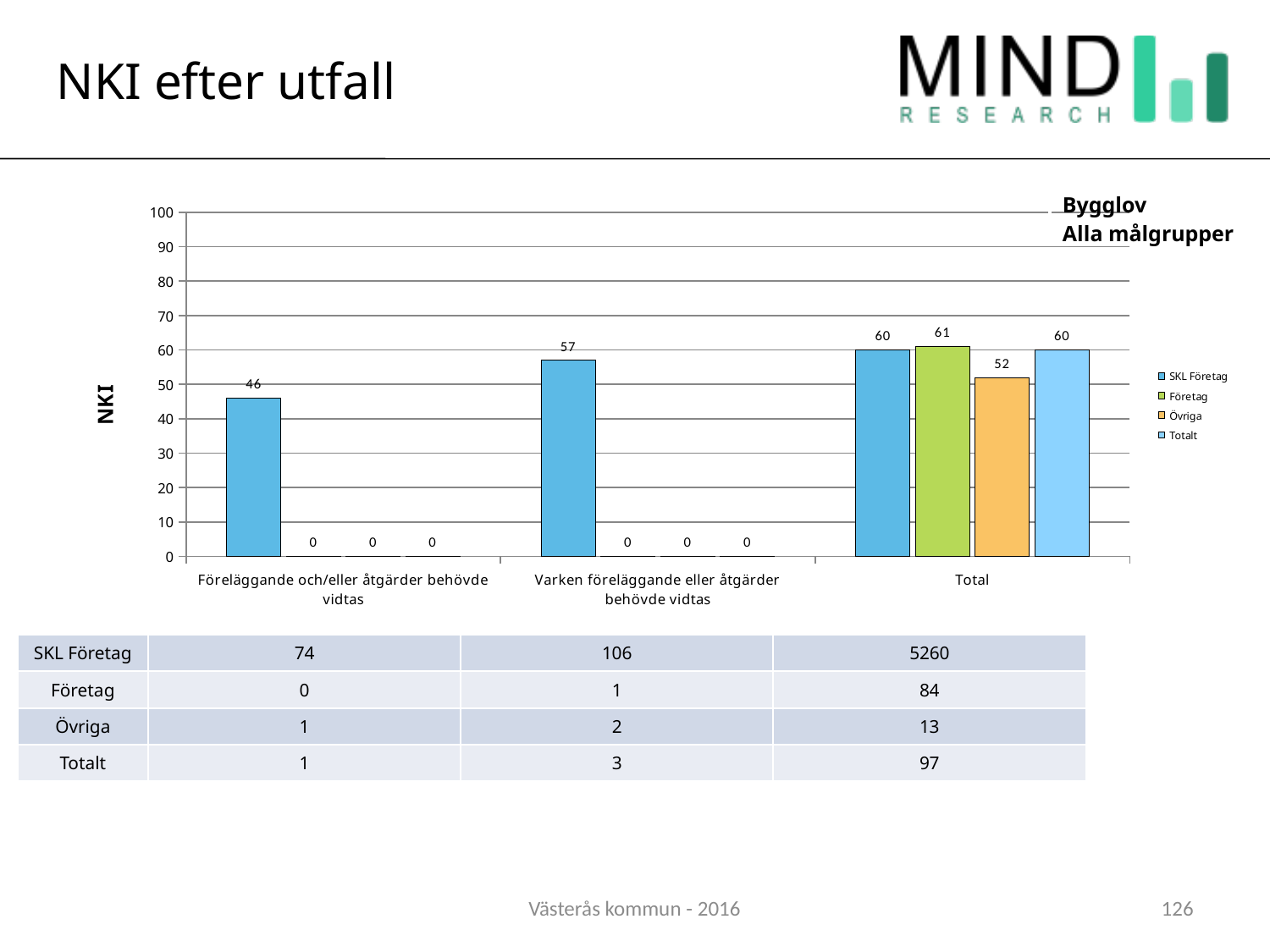
How many categories are shown on the x axis? 3 Which is larger: the Företag value or the Övriga value in the Total category? Företag What kind of chart is shown on the slide? Bar chart What is the Företag value in the Total category? 61 Which series has the highest value in the Total category? Företag What is the difference between the SKL Företag values for "Varken föreläggande eller åtgärder behövde vidtas" and "Föreläggande och/eller åtgärder behövde vidtas"? 11 Which series has the lowest value in the Total category? Övriga What is the Övriga value in the Total category? 52 What is the SKL Företag value for "Föreläggande och/eller åtgärder behövde vidtas"? 46 How many series does the legend list? 4 What is the SKL Företag value for "Varken föreläggande eller åtgärder behövde vidtas"? 57 What is the Totalt value in the Total category? 60